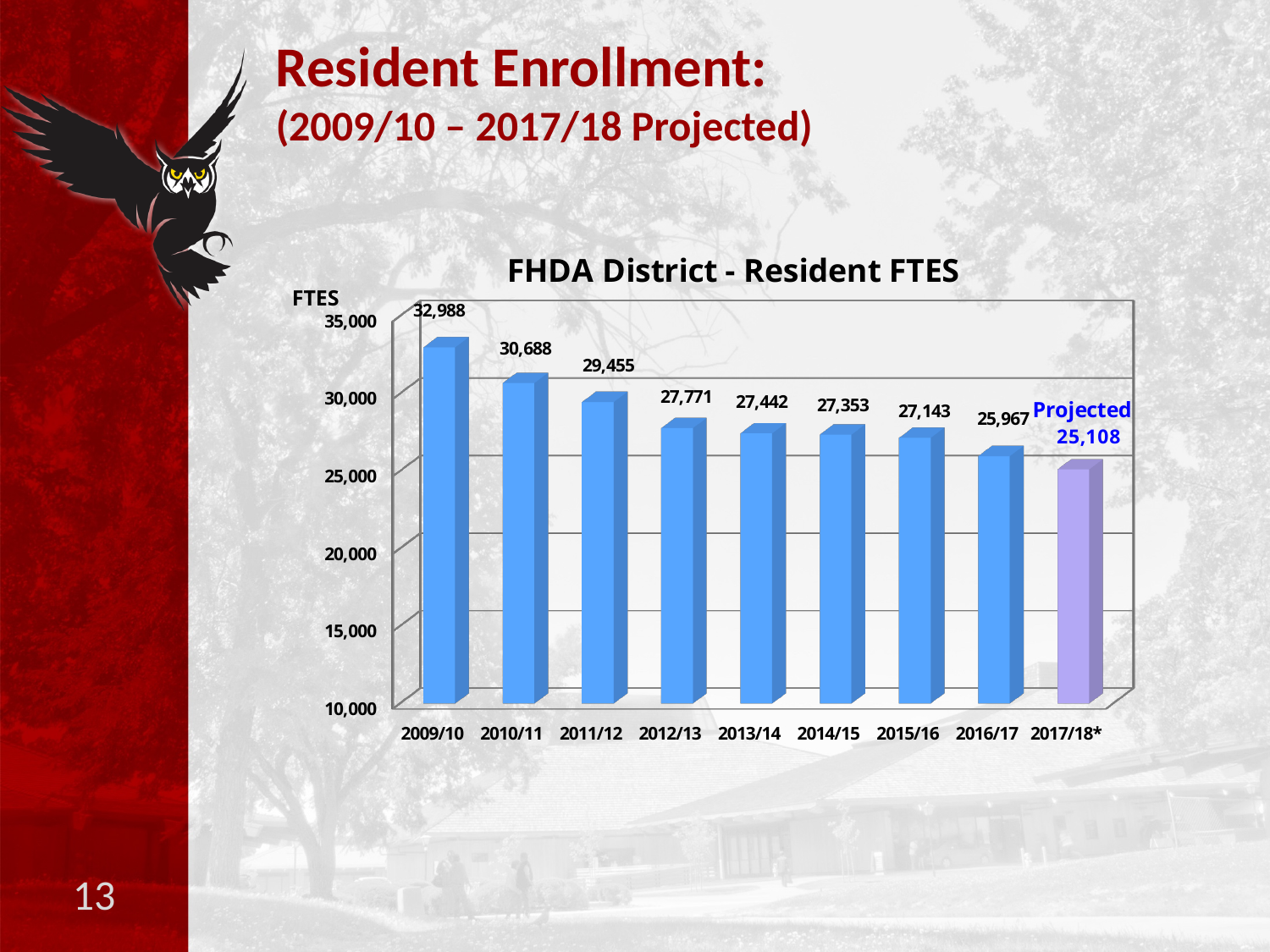
Which is larger, the Resident FTES for 2011/12 or for 2012/13? 2011/12 Do the Resident FTES values rise or fall from 2009/10 to 2017/18*? Fall What is the Resident FTES value for 2013/14? 27,442 What is the projected Resident FTES value for 2017/18*? 25,108 What is the difference in Resident FTES between 2016/17 and the projected 2017/18*? 859 What is the title of the chart? FHDA District - Resident FTES How many years are shown on the x axis of the chart? 9 Which year has the lowest Resident FTES? 2017/18* What kind of chart is shown on the slide? Bar chart What is the Resident FTES value for 2009/10? 32,988 Which year has the highest Resident FTES? 2009/10 What is the difference in Resident FTES between 2009/10 and 2010/11? 2,300